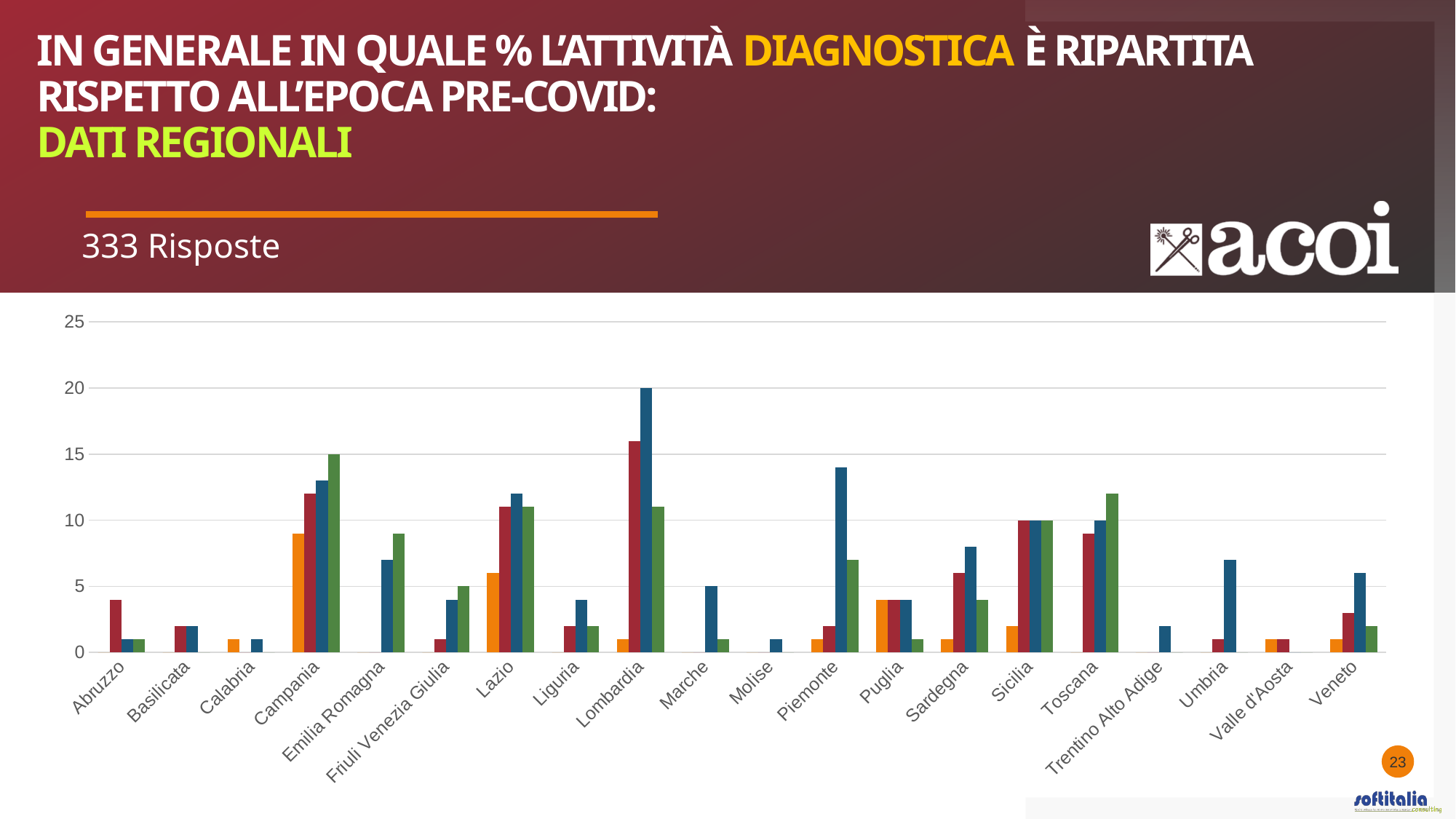
Is the red bar for Lombardia greater or less than 15? greater How many regions are listed along the x axis of the chart? 20 Which region has the tallest bar in the chart? Lombardia What value does the green bar for Campania reach on the axis? 15 How many responses does the slide say the chart is based on? 333 Risposte What value does the tallest bar for Lombardia reach on the axis? 20 Is the blue bar for Emilia Romagna greater or less than 10? less Which region has a taller blue bar, Campania or Lazio? Campania What kind of chart is shown on the slide? bar chart How many differently coloured bars are shown for each region? 4 Is the blue bar for Umbria greater or less than 5? greater